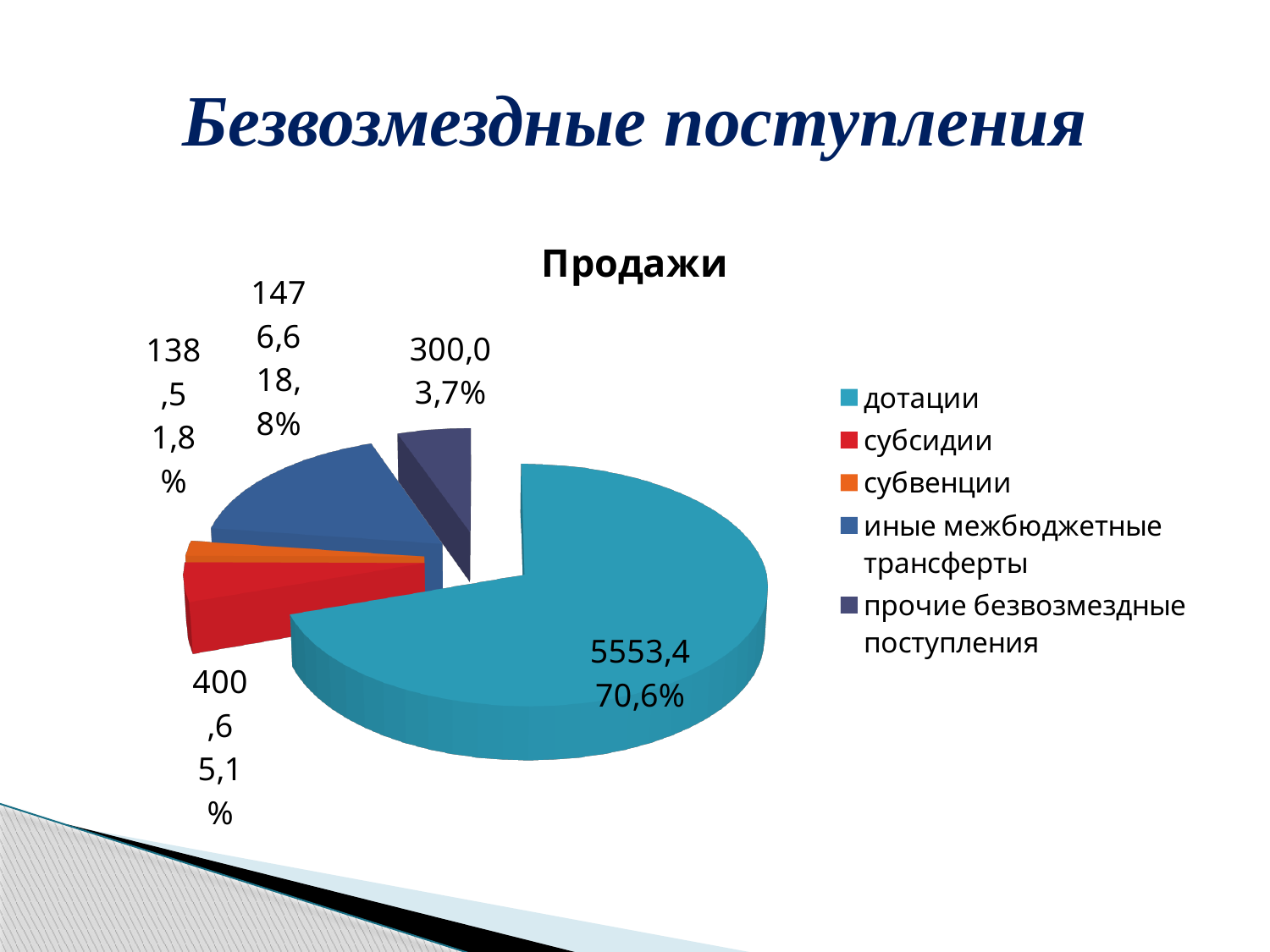
Which category has the smallest slice? субвенции Which category has the largest slice? дотации What share of the pie does дотации take? 70,6% What value is shown for дотации? 5553,4 What share of the pie does субсидии take? 5,1% What value is shown for субсидии? 400,6 What is the chart's title? Продажи How many series does the legend list? 5 What value is shown for прочие безвозмездные поступления? 300,0 Which is larger, субсидии or прочие безвозмездные поступления? субсидии What share of the pie does иные межбюджетные трансферты take? 18,8% What kind of chart is shown on the slide? pie chart